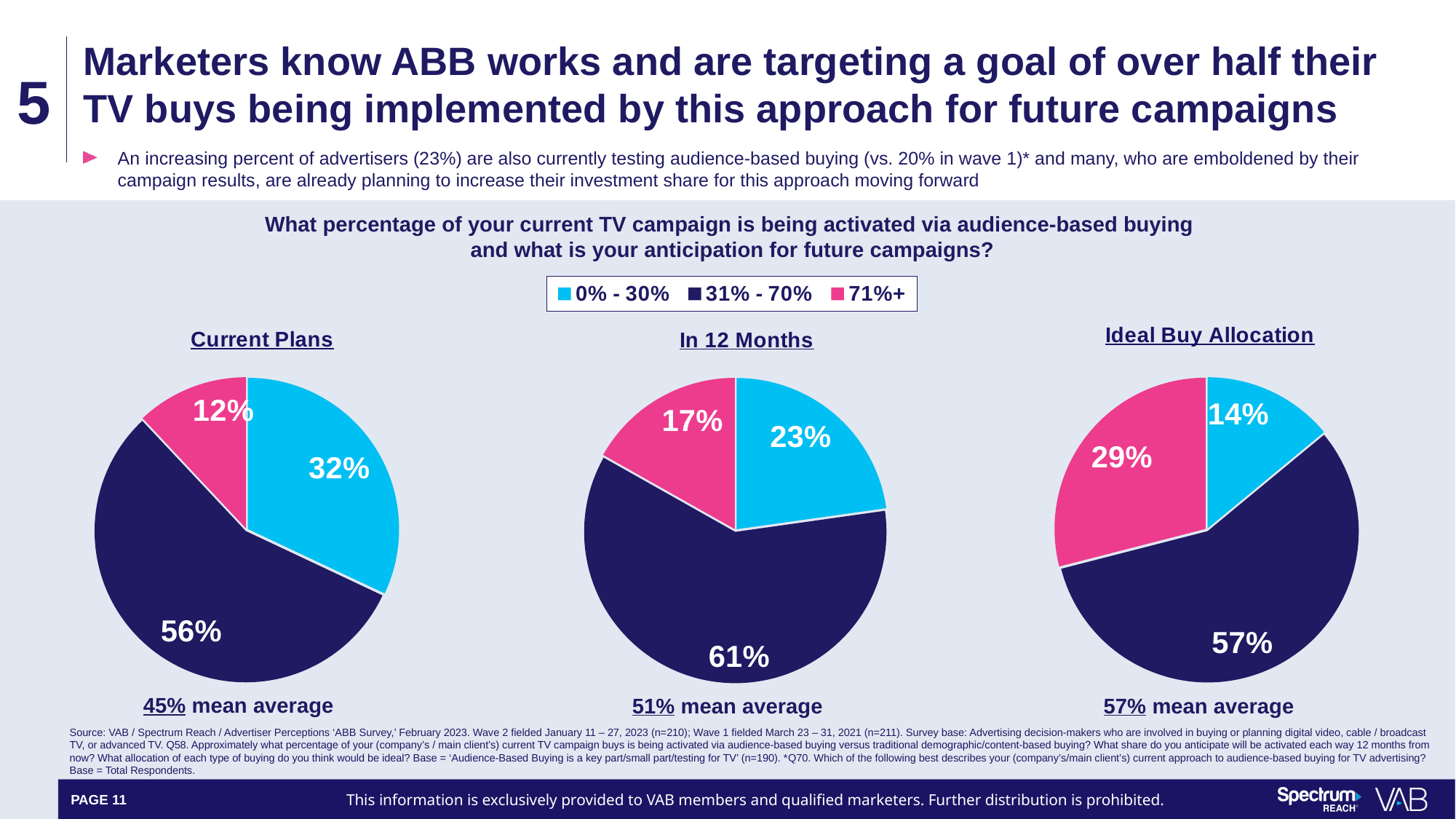
What type of chart is used for Current Plans, In 12 Months and Ideal Buy Allocation? Pie chart Which is larger in the Ideal Buy Allocation pie chart: the 0% - 30% slice or the 71%+ slice? 71%+ In the Ideal Buy Allocation pie chart, what percentage is shown for the 71%+ slice? 29% How many slices does the In 12 Months pie chart have? 3 In the Current Plans pie chart, which category has the smallest slice? 71%+ Which colour represents the 71%+ category in the legend? Pink In the In 12 Months pie chart, what percentage is shown for the 0% - 30% slice? 23% How many categories does the shared legend list? 3 In the In 12 Months pie chart, what is the difference between the 31% - 70% slice and the 0% - 30% slice? 38% What is the mean average shown below the In 12 Months pie chart? 51% In the Ideal Buy Allocation pie chart, which category has the largest slice? 31% - 70% In the Current Plans pie chart, what percentage is shown for the 31% - 70% slice? 56%